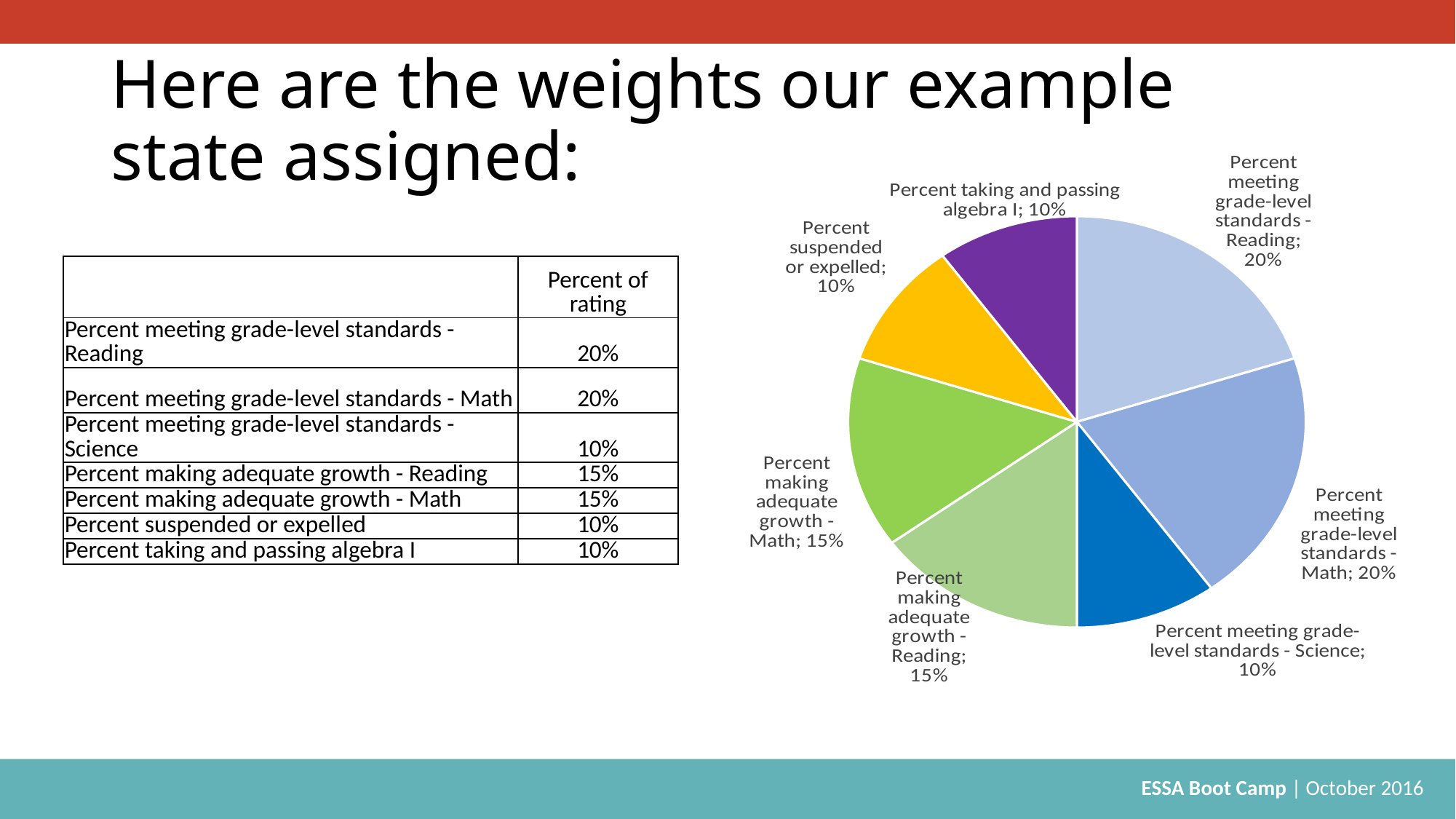
What share of the pie is 'Percent meeting grade-level standards - Science'? 10% What share of the pie is 'Percent meeting grade-level standards - Reading'? 20% How many slices in the pie chart have a share of 10%? 3 What share of the pie is 'Percent making adequate growth - Math'? 15% Which is larger: the share for 'Percent making adequate growth - Reading' or the share for 'Percent suspended or expelled'? Percent making adequate growth - Reading How many slices does the pie chart have? 7 What colour is the slice for 'Percent suspended or expelled'? yellow What kind of chart is shown on the slide? pie chart What colour is the slice for 'Percent taking and passing algebra I'? purple What is the difference between the share for 'Percent meeting grade-level standards - Math' and the share for 'Percent taking and passing algebra I'? 10% What is the difference between the share for 'Percent meeting grade-level standards - Reading' and the share for 'Percent making adequate growth - Reading'? 5%